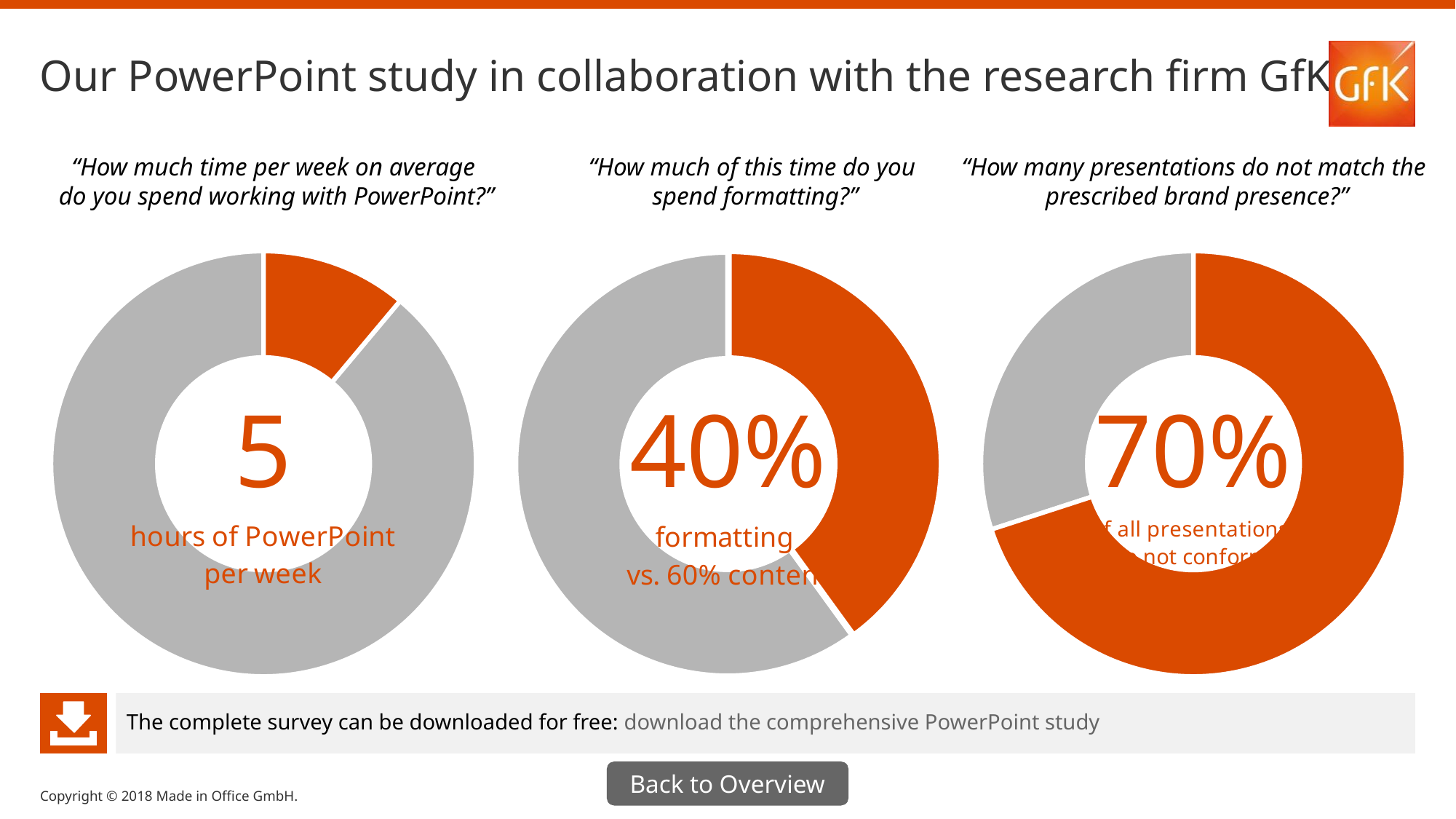
In the middle chart, what share of time is spent formatting? 40% What type of charts are shown on the slide? Donut (pie) charts In the middle chart, which is larger: the share for formatting or the share for content? content In the right chart, is the orange slice greater or less than 50% of the donut? greater In the middle chart, what is the difference between the content share and the formatting share? 20% In the right chart, what percentage of presentations do not conform to the prescribed brand presence? 70% What question is the middle chart answering? "How much of this time do you spend formatting?" In the left chart, is the orange slice greater or less than 50% of the donut? less In the left chart, how many hours of PowerPoint per week does the central figure show? 5 In the middle chart, what share of time is spent on content? 60% How many donut charts are on the slide? 3 Which of the three charts shows the largest orange share? The right chart (70%)